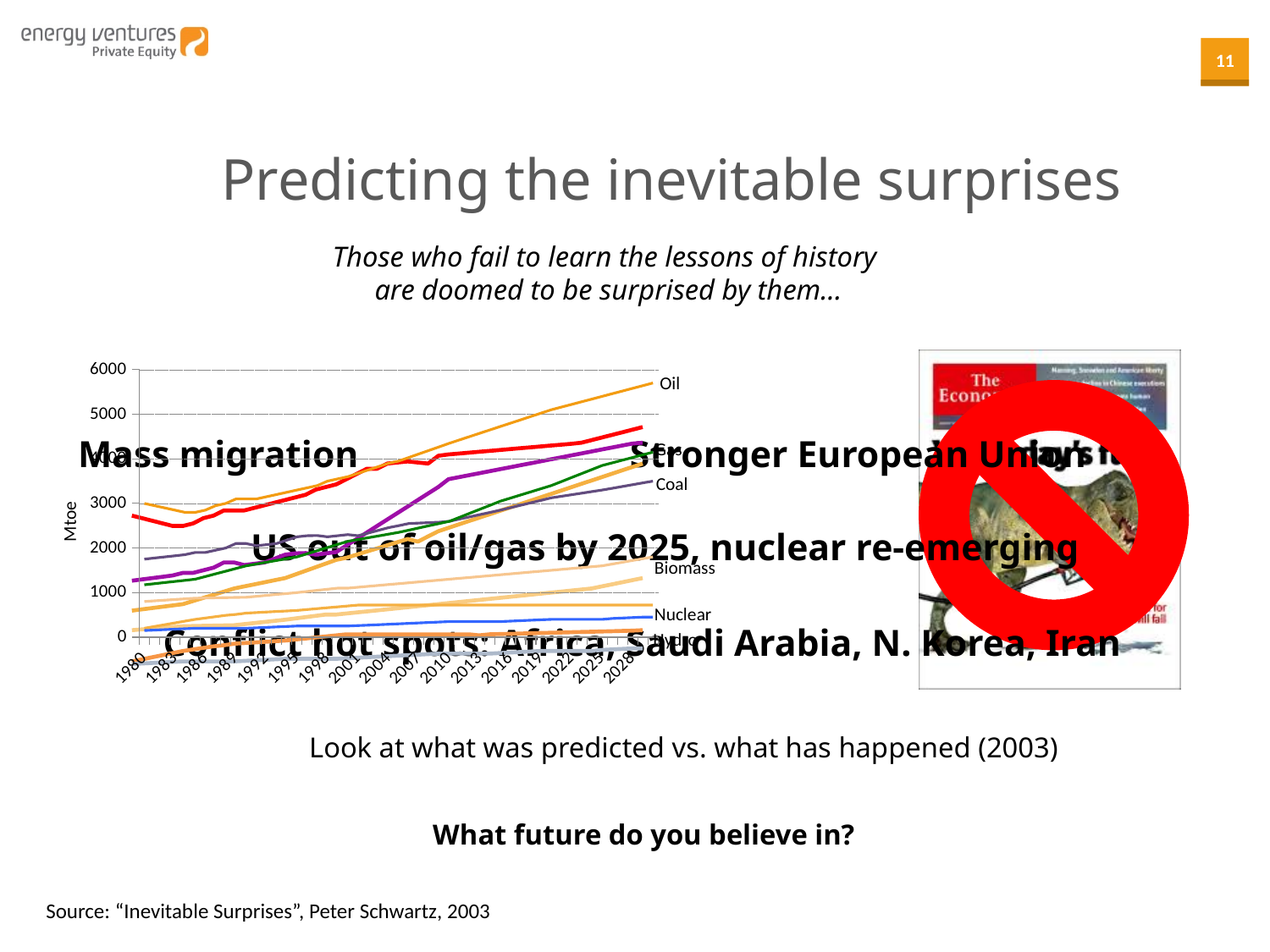
At the right end of the chart, which is larger, Coal or Nuclear? Coal What kind of chart is shown on the slide? Line chart At the right end of the chart, which is larger, Oil or Coal? Oil What is the first year shown on the x-axis of the chart? 1980 Is the value for Oil at the right end of the chart greater or less than 5000? greater Is the value for Coal at the right end of the chart greater or less than 3000? greater Is the value for Hydro at the right end of the chart greater or less than 1000? less What unit is shown on the y-axis of the chart? Mtoe Does the Oil series rise or fall from 1980 to 2028? Rises What is the highest value shown on the y-axis of the chart? 6000 Which series has the highest value at the right end of the chart? Oil